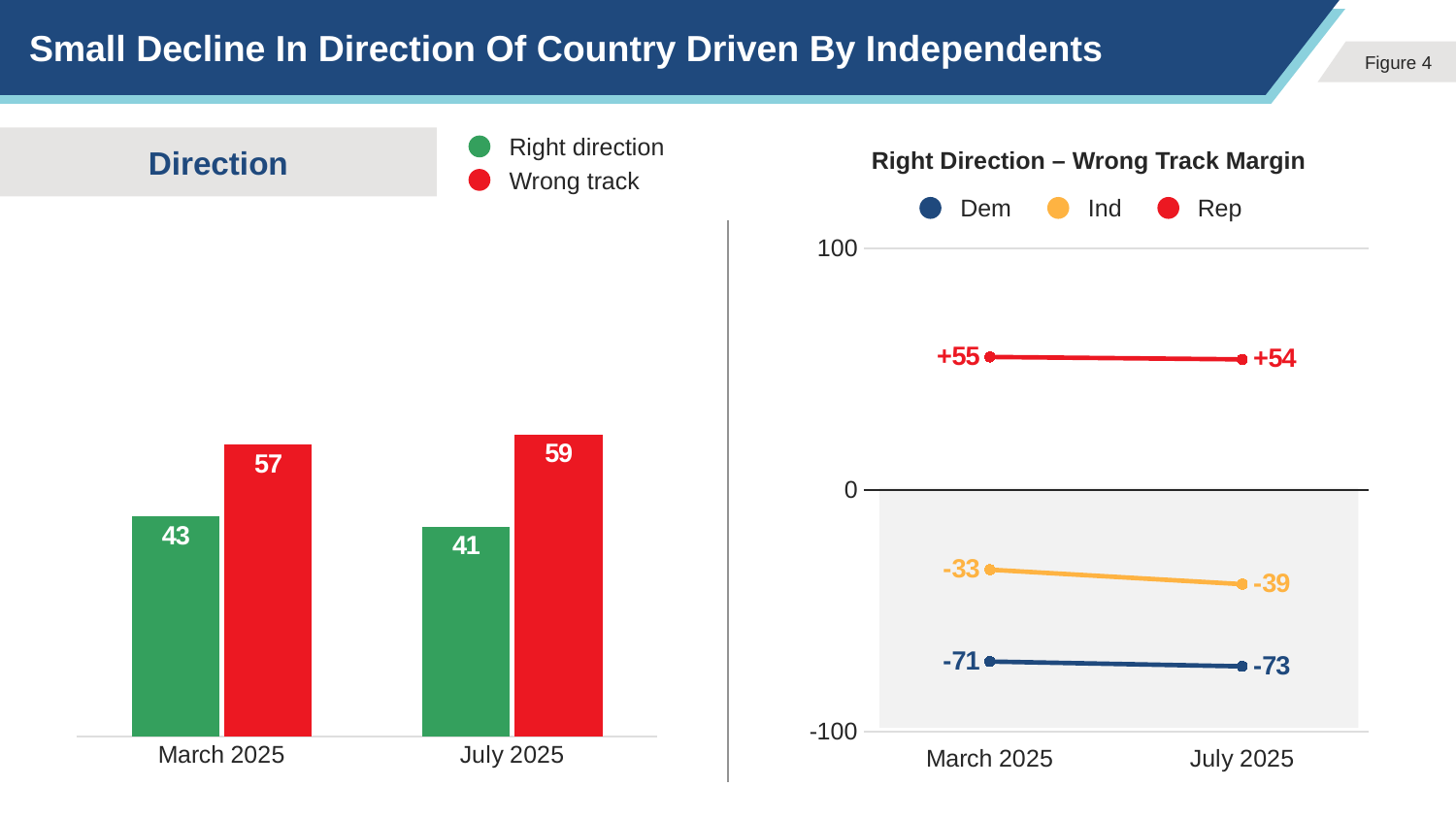
In the Right Direction – Wrong Track Margin chart, what is the difference between the Ind values for March 2025 and July 2025? 6 In the Right Direction – Wrong Track Margin chart, how many series does the legend list? 3 What kind of chart is the Direction chart? bar chart In the Right Direction – Wrong Track Margin chart, what is the value for Rep in March 2025? +55 In the Right Direction – Wrong Track Margin chart, which group has the lowest value in July 2025? Dem In the Direction chart, what is the difference between Wrong track and Right direction in July 2025? 18 In the Right Direction – Wrong Track Margin chart, what is the value for Ind in July 2025? -39 In the Direction chart, does the Right direction value rise or fall from March 2025 to July 2025? fall In the Direction chart, which is larger in March 2025, Right direction or Wrong track? Wrong track In the Direction chart, what is the value for Wrong track in July 2025? 59 What kind of chart is the Right Direction – Wrong Track Margin chart? line chart In the Direction chart, what is the value for Right direction in March 2025? 43